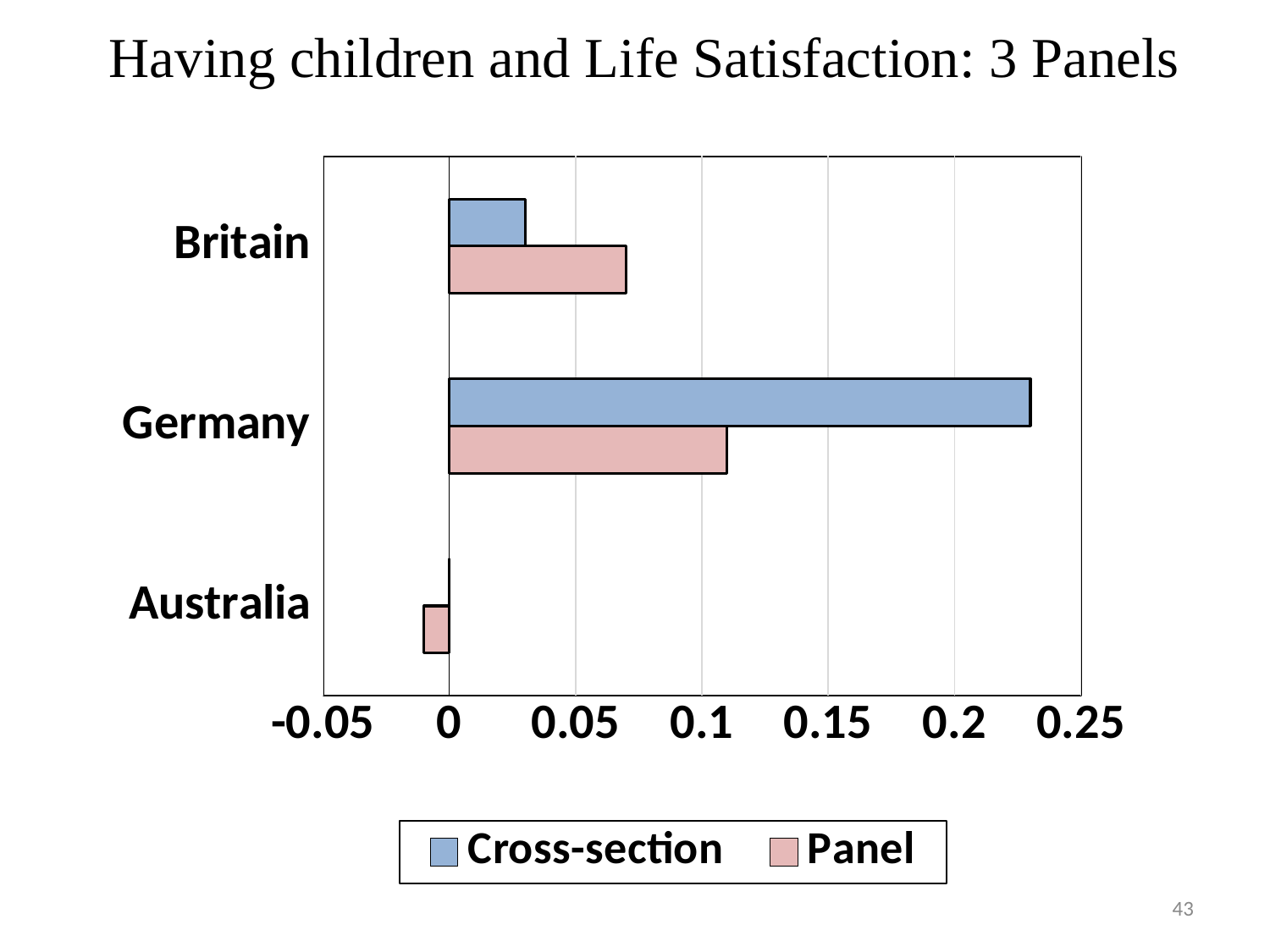
What is the title of the slide? Having children and Life Satisfaction: 3 Panels Which country has the highest Cross-section value? Germany Is the Panel value for Australia greater or less than 0? less Is the Panel value for Britain greater or less than 0.05? greater For Britain, which is larger: the Cross-section value or the Panel value? Panel For Germany, which is larger: the Cross-section value or the Panel value? Cross-section How many series does the legend list? 2 What kind of chart is shown on the slide? Bar chart Is the Cross-section value for Germany greater or less than 0.2? greater Which country has the lowest Panel value? Australia How many countries are shown on the chart? 3